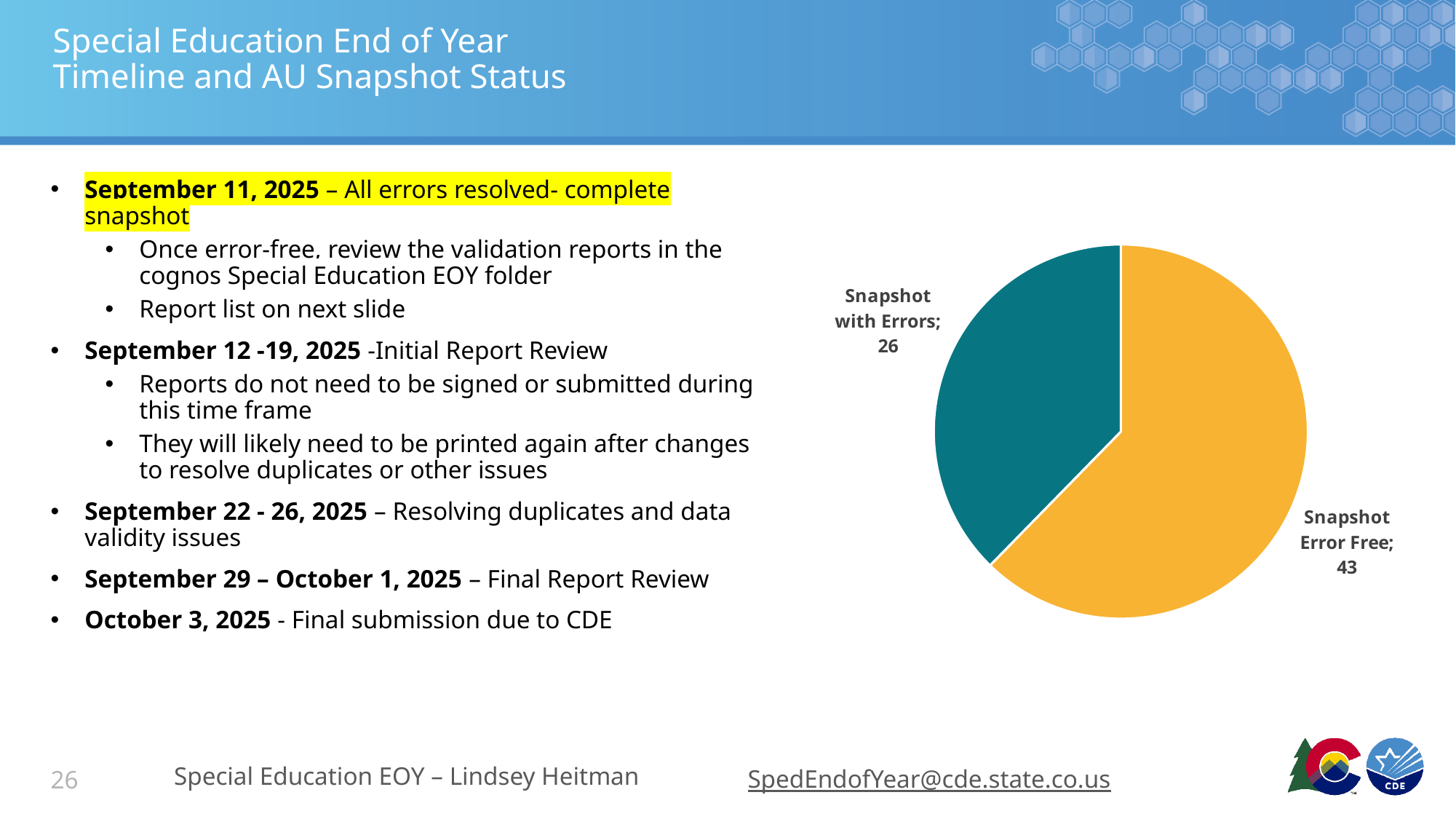
Which category has the smallest slice in the pie chart? Snapshot with Errors What share of the total does Snapshot Error Free represent, rounded to the nearest whole percent? 62% Which is larger, Snapshot Error Free or Snapshot with Errors? Snapshot Error Free What is the value for Snapshot Error Free in the pie chart? 43 How many slices does the pie chart have? 2 What colour is the Snapshot Error Free slice in the pie chart? orange What is the difference between the Snapshot Error Free value and the Snapshot with Errors value? 17 What is the total of the two values shown in the pie chart? 69 What is the value for Snapshot with Errors in the pie chart? 26 Which category has the largest slice in the pie chart? Snapshot Error Free What colour is the Snapshot with Errors slice in the pie chart? teal What kind of chart is shown on the slide? pie chart